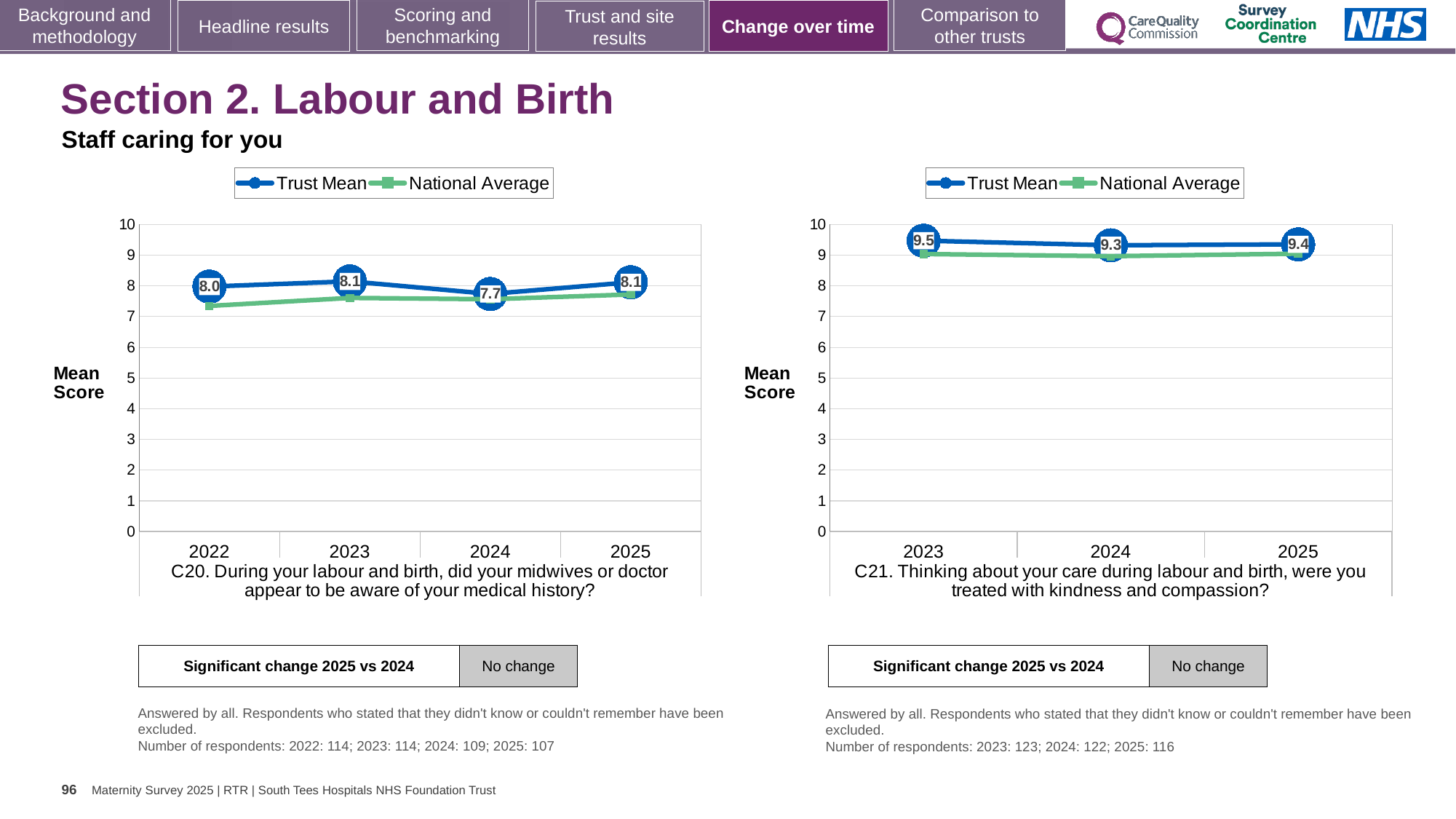
In the C21 chart on the right, is the Trust Mean higher in 2023 or in 2024? 2023 In the C20 chart on the left, what is the Trust Mean for 2022? 8.0 In the C20 chart on the left, what is the difference between the Trust Mean for 2025 and the Trust Mean for 2024? 0.4 How many years are shown on the x axis of the C21 chart on the right? 3 What type of chart is the C20 chart on the left? Line chart In the C21 chart on the right, which year has the lowest Trust Mean? 2024 In the C21 chart on the right, which year has the highest Trust Mean? 2023 How many series does the legend of the C20 chart on the left list? 2 In the C20 chart on the left, what is the Trust Mean for 2024? 7.7 In the C21 chart on the right, what is the Trust Mean for 2025? 9.4 In the C20 chart on the left, is the National Average for 2022 greater or less than 8? less In the C20 chart on the left, which year has the lowest Trust Mean? 2024